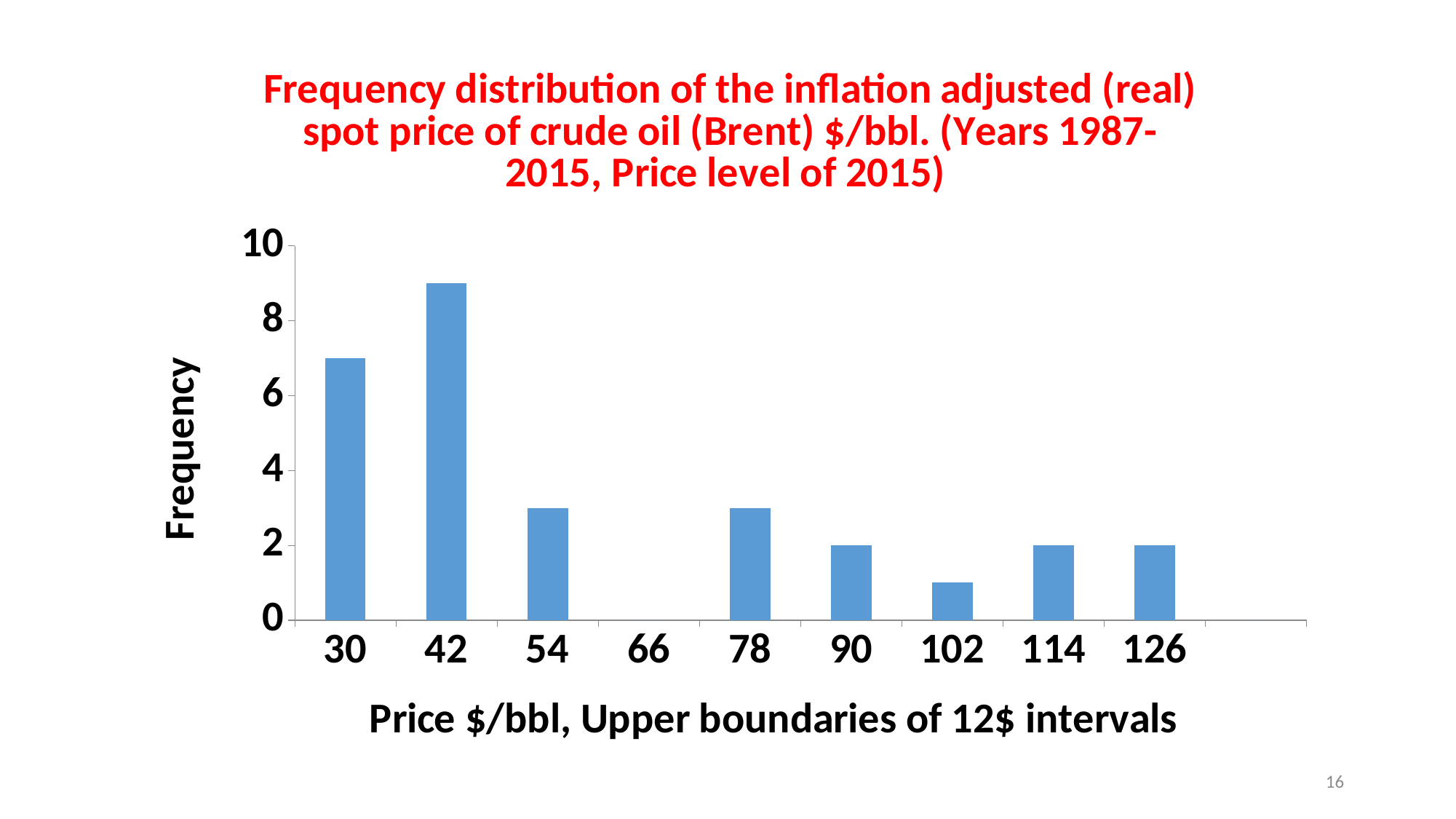
Which has the higher frequency, the 30 interval or the 42 interval? 42 What kind of chart is shown on the slide? bar chart What is the frequency for the 66 price interval? 0 Is the frequency for the 30 price interval greater or less than 6? greater How many price intervals are labelled on the x axis? 9 What is the frequency for the 90 price interval? 2 Is the frequency for the 54 price interval greater or less than 4? less What is the frequency for the 114 price interval? 2 Is the frequency for the 102 price interval greater or less than 2? less Which price interval has the lowest frequency? 66 Which price interval has the highest frequency? 42 What is the label of the y axis? Frequency